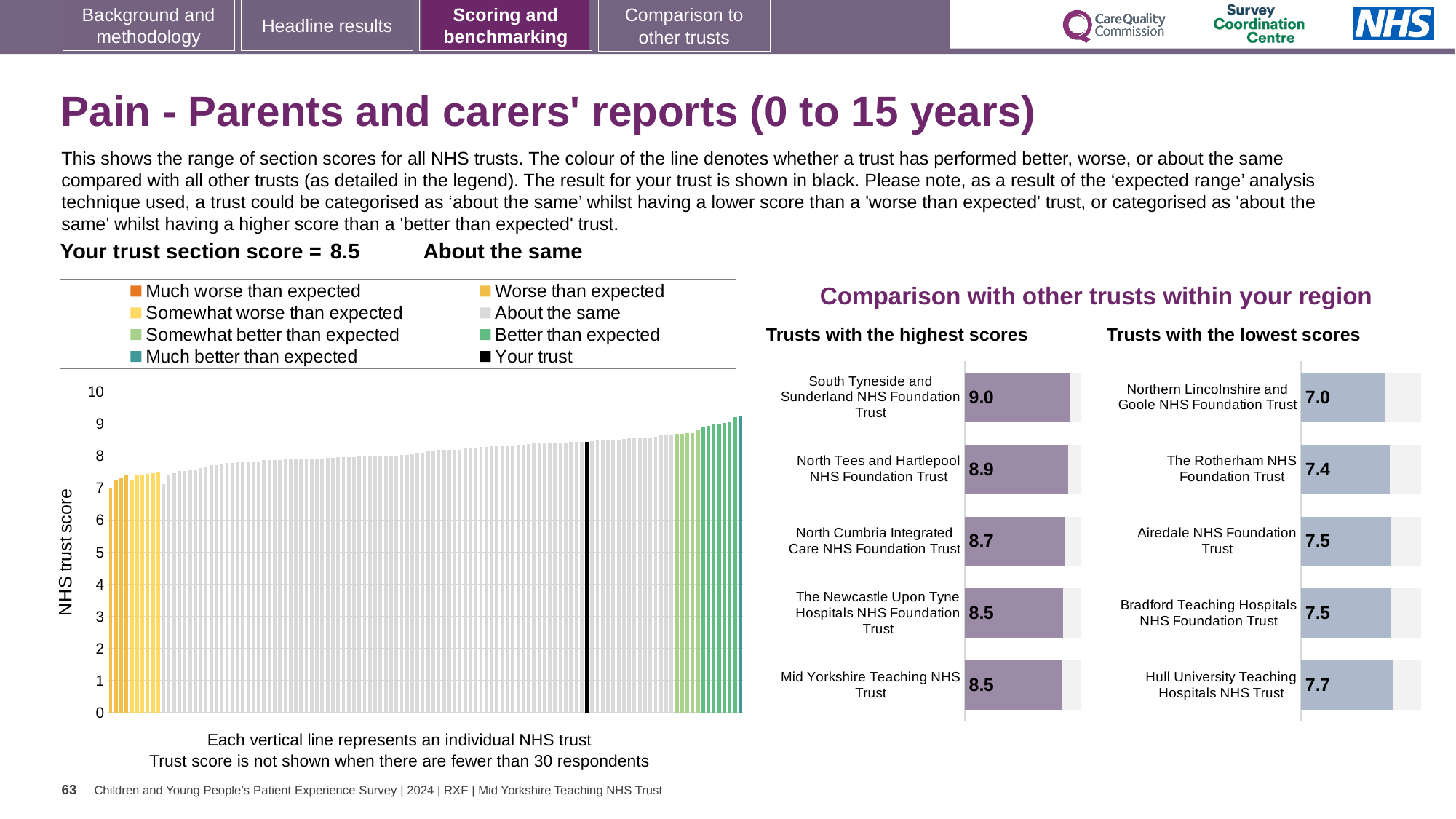
In the 'Trusts with the highest scores' chart, what is the score for North Cumbria Integrated Care NHS Foundation Trust? 8.7 In the 'Trusts with the highest scores' chart, what is the difference between the scores of South Tyneside and Sunderland NHS Foundation Trust and Mid Yorkshire Teaching NHS Trust? 0.5 In the 'Trusts with the highest scores' chart, which trust has the highest score? South Tyneside and Sunderland NHS Foundation Trust In the 'Trusts with the lowest scores' chart, what is the score for The Rotherham NHS Foundation Trust? 7.4 What type of chart is the 'NHS trust score' chart on the left of the slide? Bar chart In the 'NHS trust score' chart on the left, is the value for the black 'Your trust' bar greater or less than 8? greater In the 'Trusts with the lowest scores' chart, which has the higher score: Hull University Teaching Hospitals NHS Trust or Airedale NHS Foundation Trust? Hull University Teaching Hospitals NHS Trust In the 'Trusts with the highest scores' chart, what is the score for South Tyneside and Sunderland NHS Foundation Trust? 9.0 What is the y-axis label of the bar chart on the left of the slide? NHS trust score In the 'Trusts with the lowest scores' chart, which trust has the lowest score? Northern Lincolnshire and Goole NHS Foundation Trust How many trusts are shown in the 'Trusts with the lowest scores' chart? 5 How many entries does the legend of the 'NHS trust score' chart on the left list? 8